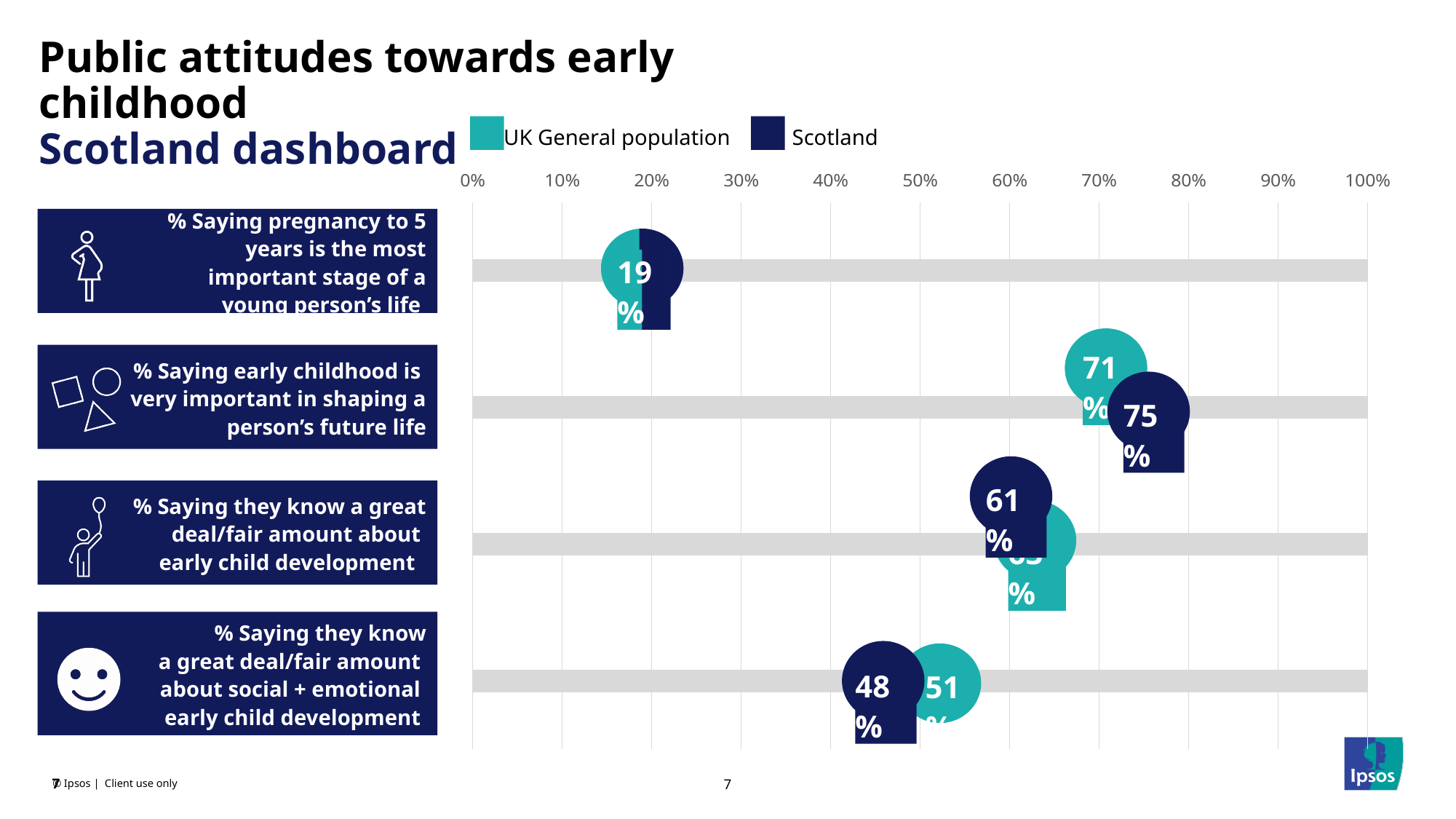
How many series does the legend list? 2 What percentage of the UK General population say they know a great deal/fair amount about social + emotional early child development? 51% For knowing a great deal/fair amount about social + emotional early child development, which is larger: the UK General population or Scotland? UK General population What percentage of the UK General population say early childhood is very important in shaping a person's future life? 71% What percentage of Scotland respondents say they know a great deal/fair amount about early child development? 61% For saying early childhood is very important in shaping a person's future life, how many percentage points higher is Scotland than the UK General population? 4 percentage points What percentage of Scotland respondents say they know a great deal/fair amount about social + emotional early child development? 48% What percentage of Scotland respondents say early childhood is very important in shaping a person's future life? 75% Which statement has the highest Scotland value? % Saying early childhood is very important in shaping a person's future life Is the Scotland value for saying pregnancy to 5 years is the most important stage greater or less than 30%? less What percentage of the UK General population say pregnancy to 5 years is the most important stage of a young person's life? 19% How many statements (rows) are plotted on the chart? 4